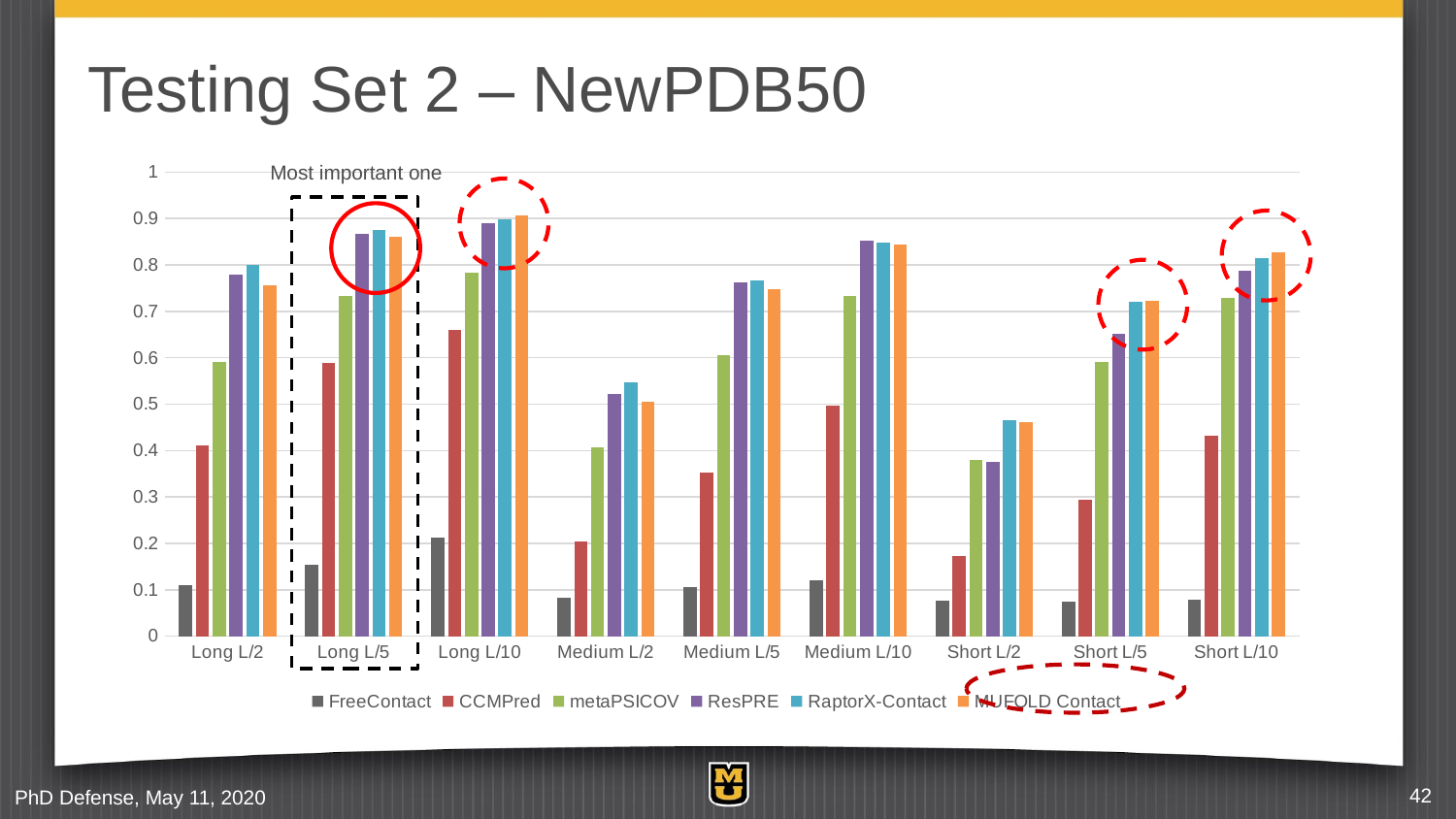
In which category does MUFOLD Contact reach its highest value? Long L/10 Is the value for FreeContact at Long L/2 greater or less than 0.2? less Which series has the lowest value in the Long L/2 category? FreeContact What kind of chart is shown on the slide? bar chart Which is larger: the CCMPred value at Long L/2 or at Long L/5? Long L/5 How many series does the legend list? 6 Is the value for RaptorX-Contact at Short L/2 greater or less than 0.5? less Is the value for ResPRE at Medium L/10 greater or less than 0.8? greater How many categories are shown along the x axis? 9 Do the FreeContact values rise or fall going from Long L/2 to Long L/5 to Long L/10? rise Which category is enclosed by the dashed box labelled 'Most important one'? Long L/5